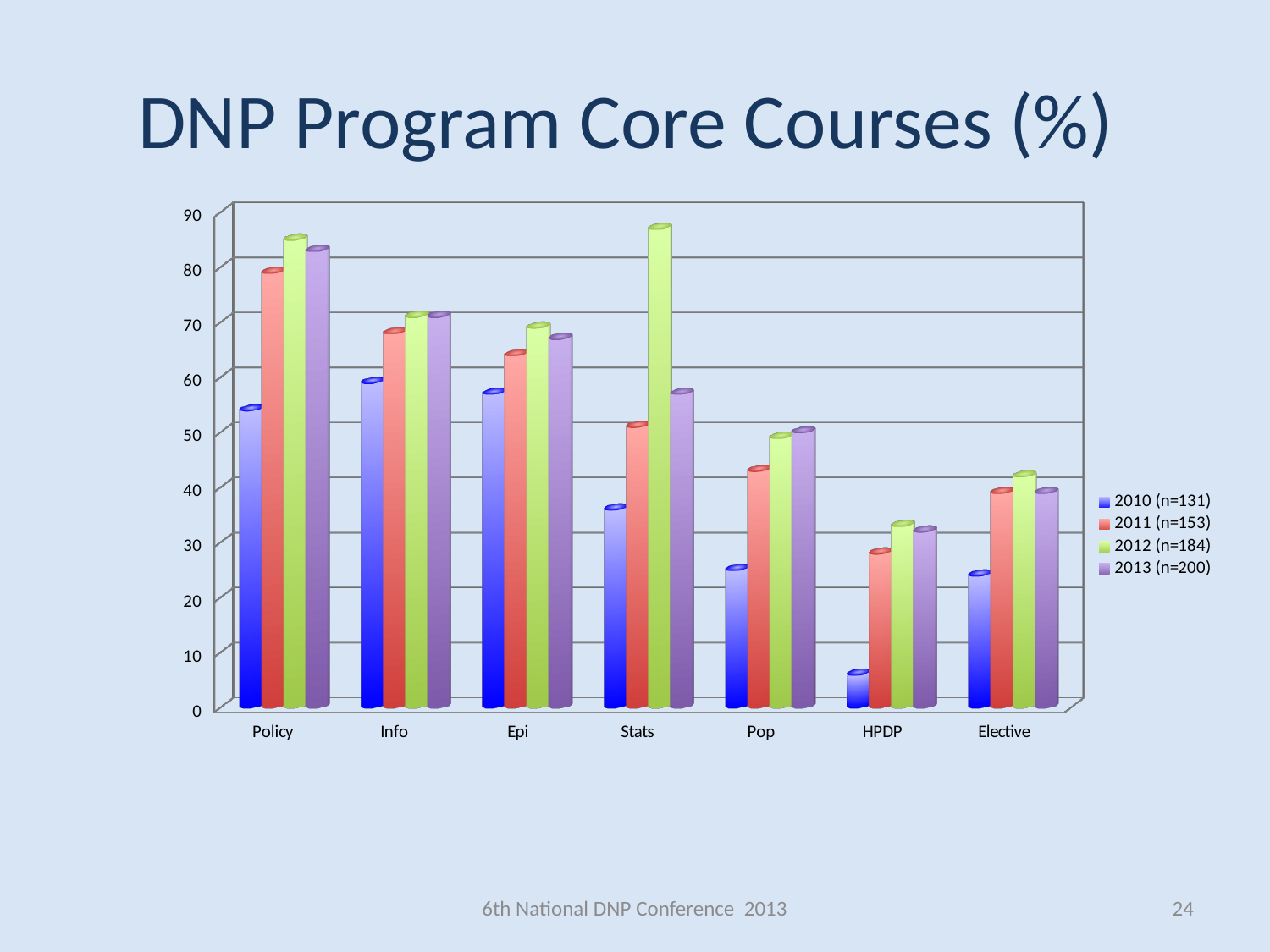
Which category has the lowest value for the 2013 (n=200) series? HPDP How many course categories are shown on the x axis? 7 What kind of chart is shown on the slide? bar chart Is the 2011 (n=153) value for Policy greater or less than 70? greater Is the 2012 (n=184) value for Stats greater or less than 80? greater Is the 2010 (n=131) value for HPDP greater or less than 10? less What is the legend label for the purple series? 2013 (n=200) For Stats, which is larger: the 2011 (n=153) value or the 2012 (n=184) value? 2012 (n=184) Which category has the lowest value for the 2010 (n=131) series? HPDP How many series does the legend list? 4 Which category has the highest value for the 2011 (n=153) series? Policy For the 2011 (n=153) series, which is larger: HPDP or Elective? Elective